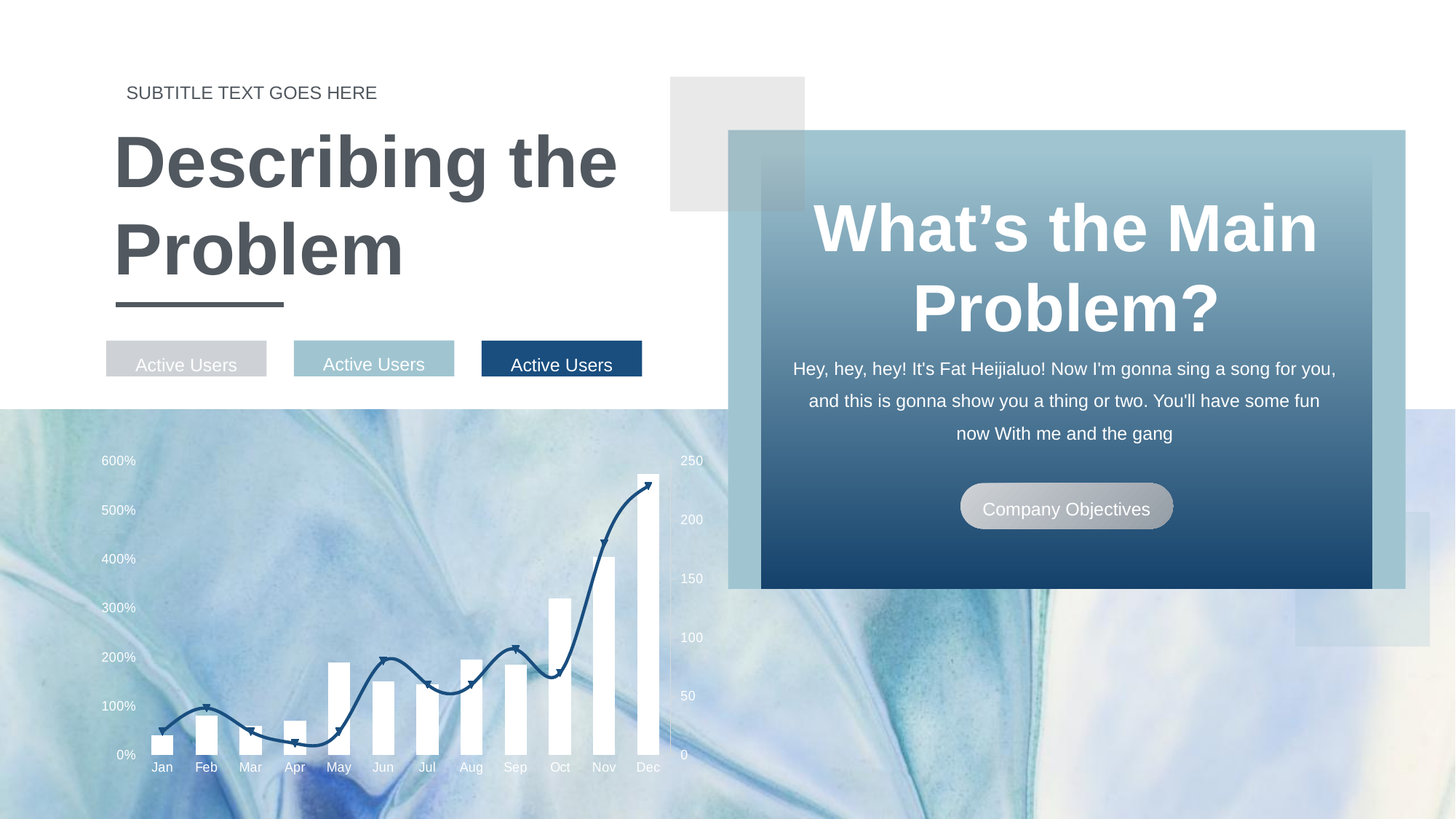
Is the Dec bar above or below the 500% mark on the left axis? Above What is the highest tick label on the right vertical axis of the chart? 250 Is the bar for Dec larger or smaller than the bar for Jan? Larger Which bar is taller, Oct or Feb? Oct Which month has the tallest bar in the chart? Dec Which month has the shortest bar in the chart? Jan Is the Oct bar above or below the 200% mark on the left axis? Above Is the Jan bar above or below the 100% mark on the left axis? Below What is the highest tick label on the left vertical axis of the chart? 600% What kind of chart is shown at the bottom left of the slide? A combined bar and line chart Do the bar values generally rise or fall from Jan to Dec? Rise How many months are shown along the x axis of the chart? 12